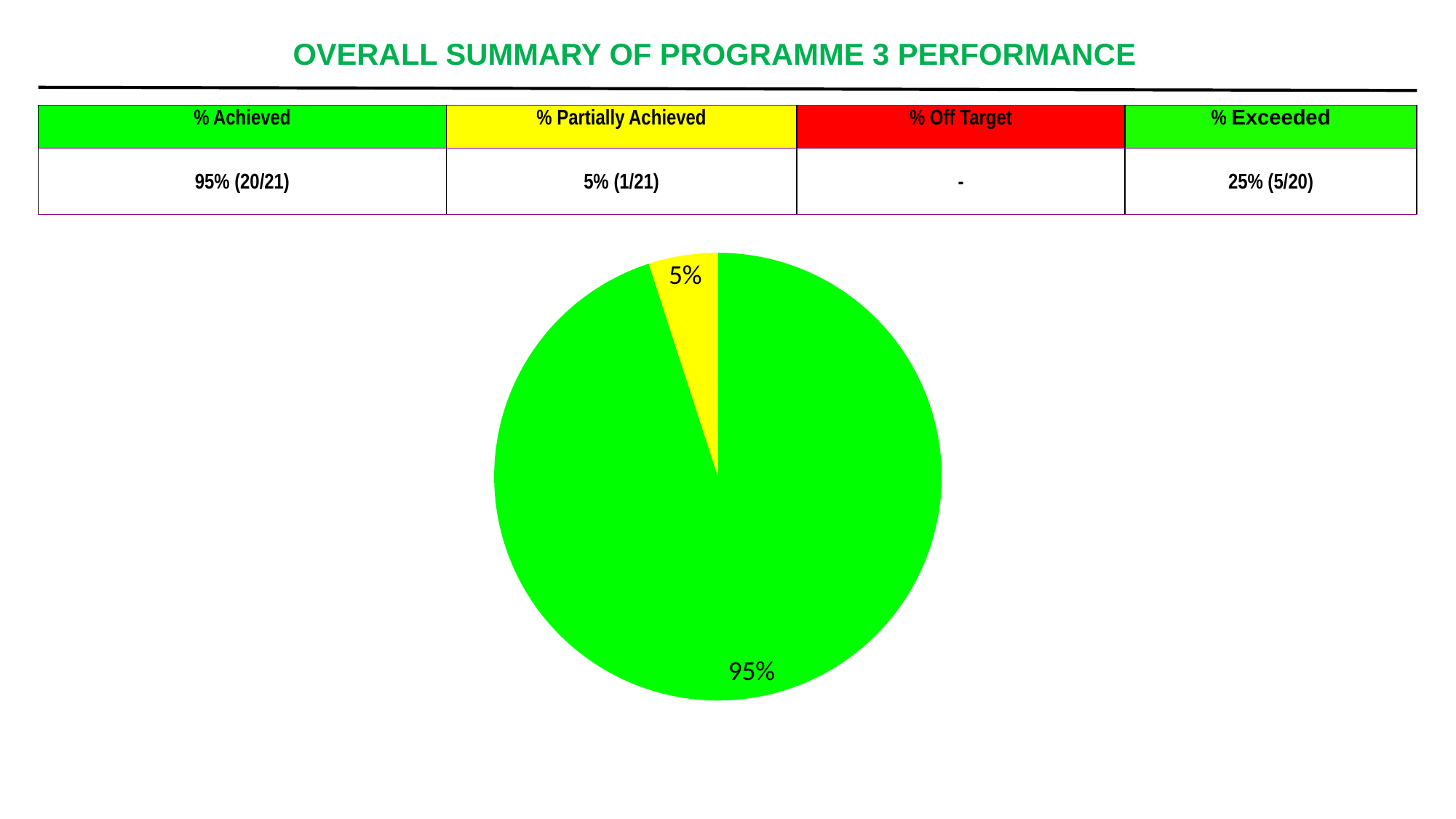
What share of the pie does the green slice represent? 95% How many slices does the pie chart have? 2 What kind of chart is shown on the slide? pie chart What is the difference in percentage points between the green slice and the yellow slice? 90 Is the share of the green slice greater or less than 50%? greater Which slice of the pie chart is the smallest? the yellow slice (5%) What is the title at the top of the slide? OVERALL SUMMARY OF PROGRAMME 3 PERFORMANCE Which is larger, the green slice or the yellow slice? the green slice Which slice of the pie chart is the largest? the green slice (95%) What colour is the slice labelled 5%? yellow What is the total of the two slice labels shown on the pie chart? 100% What share of the pie does the yellow slice represent? 5%